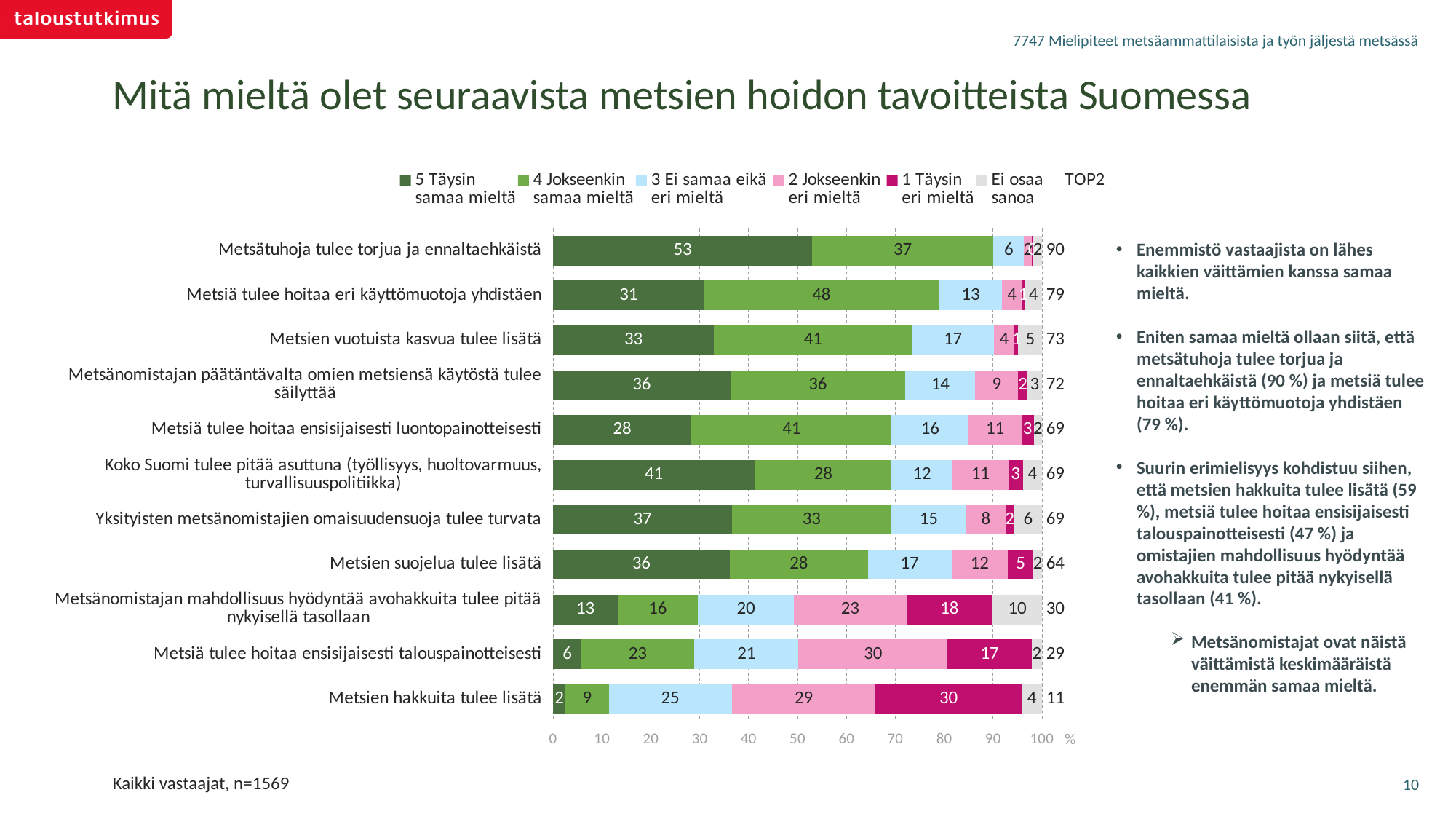
How many statements (categories) are plotted in the chart? 11 How many response series does the legend list (excluding the TOP2 label)? 6 What is the '2 Jokseenkin eri mieltä' value for 'Metsänomistajan mahdollisuus hyödyntää avohakkuita tulee pitää nykyisellä tasollaan'? 23 What is the TOP2 value for 'Metsiä tulee hoitaa eri käyttömuotoja yhdistäen'? 79 What is the difference between the '4 Jokseenkin samaa mieltä' values for 'Metsiä tulee hoitaa eri käyttömuotoja yhdistäen' and 'Metsien suojelua tulee lisätä'? 20 Which has a larger '3 Ei samaa eikä eri mieltä' value: 'Metsien hakkuita tulee lisätä' or 'Metsien vuotuista kasvua tulee lisätä'? Metsien hakkuita tulee lisätä What type of chart is shown on the slide? Stacked bar chart Which statement has the highest TOP2 value? Metsätuhoja tulee torjua ja ennaltaehkäistä What is the '1 Täysin eri mieltä' value for 'Metsien hakkuita tulee lisätä'? 30 What is the sample size stated below the chart? n=1569 Which statement has the lowest TOP2 value? Metsien hakkuita tulee lisätä What is the '5 Täysin samaa mieltä' value for 'Metsätuhoja tulee torjua ja ennaltaehkäistä'? 53